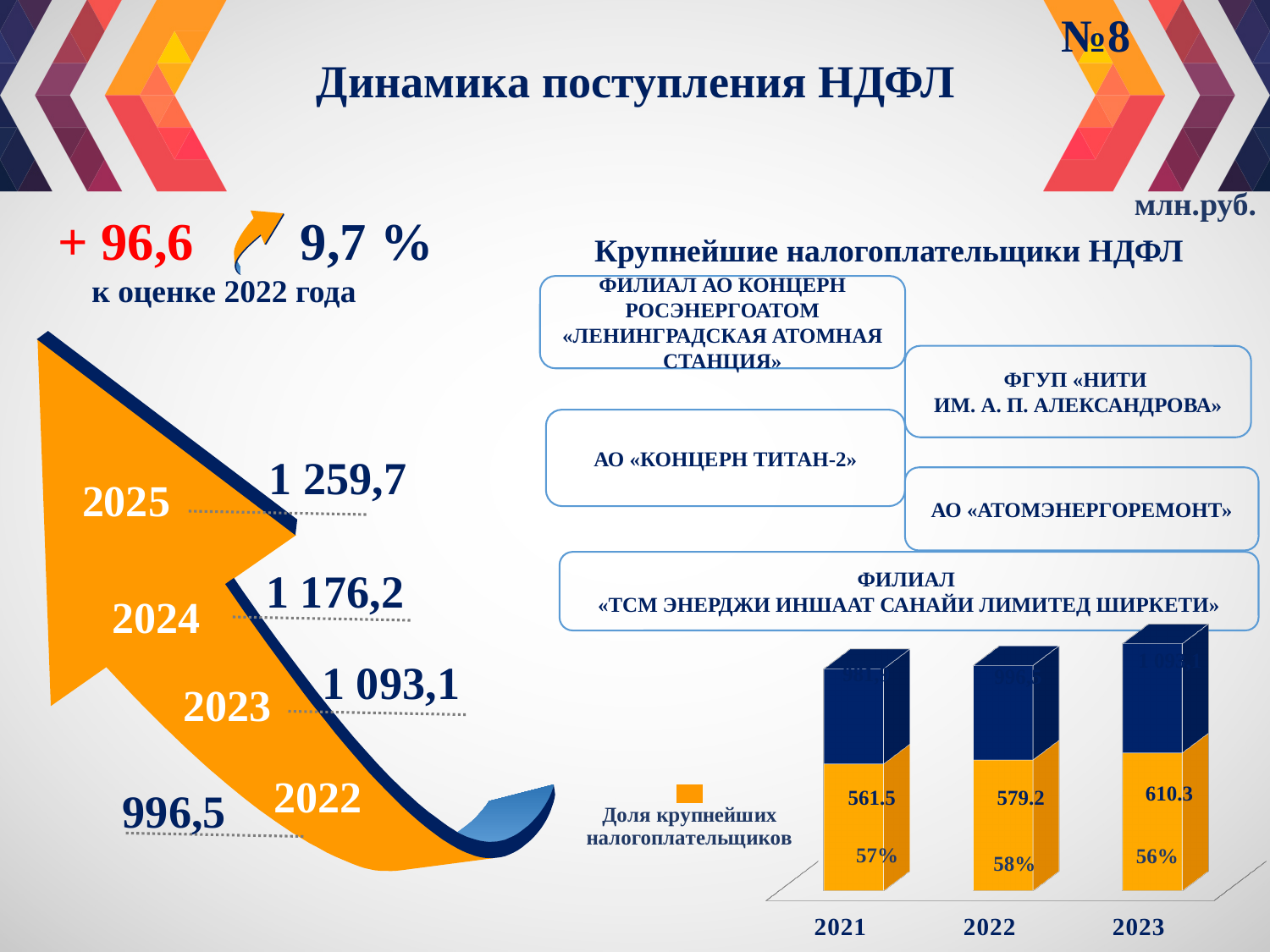
In the bar chart at the bottom right, what is the value of the orange segment for 2023? 610.3 In the arrow graphic on the left, what value is shown for 2025? 1 259,7 In the bar chart at the bottom right, which year has the highest orange segment value? 2023 In the bar chart at the bottom right, which year has the lowest share percentage printed on the orange segment? 2023 In the bar chart at the bottom right, what percentage is shown on the orange segment for 2022? 58% How many years are shown on the x axis of the bar chart at the bottom right? 3 In the bar chart at the bottom right, do the orange segment values rise or fall from 2021 to 2023? Rise What kind of chart is shown at the bottom right of the slide? Stacked bar chart In the bar chart at the bottom right, what is the value of the orange segment for 2021? 561.5 What does the orange legend entry next to the bar chart at the bottom right say? Доля крупнейших налогоплательщиков In the bar chart at the bottom right, what is the difference between the orange segment values for 2023 and 2021? 48.8 In the bar chart at the bottom right, which is larger: the orange segment value for 2022 or for 2021? 2022